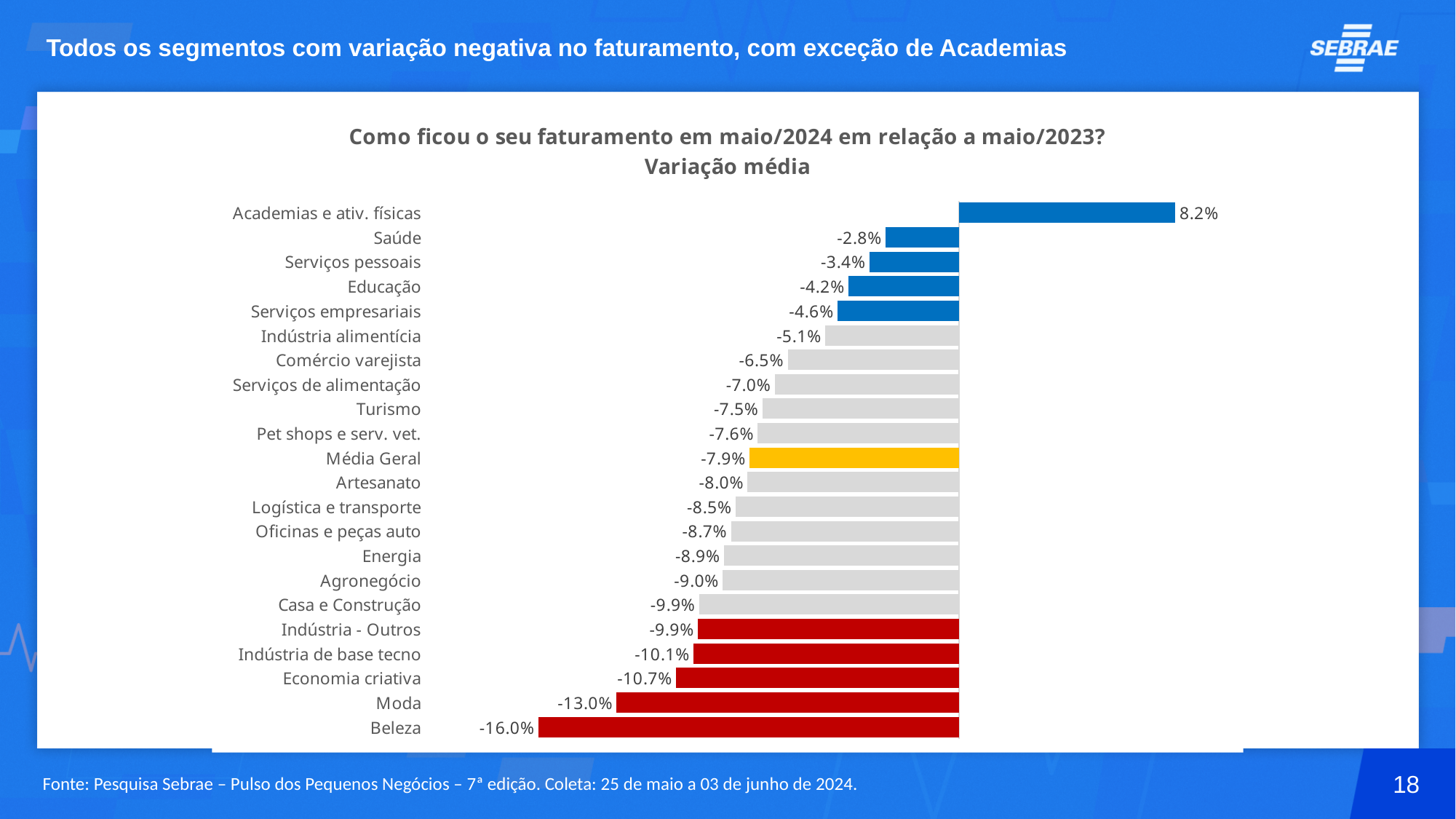
What is the difference between the values for Moda and Beleza? 3.0 percentage points Which has a larger value, Turismo or Energia? Turismo Which category has the highest value? Academias e ativ. físicas What is the value for Comércio varejista? -6.5% What is the value for Média Geral? -7.9% Which category has the lowest value? Beleza What is the value for Moda? -13.0% What kind of chart is shown on the slide? Bar chart What colour is the bar for Média Geral? Yellow What is the value for Academias e ativ. físicas? 8.2% How many categories are shown in the chart? 22 What is the difference between the values for Saúde and Educação? 1.4 percentage points